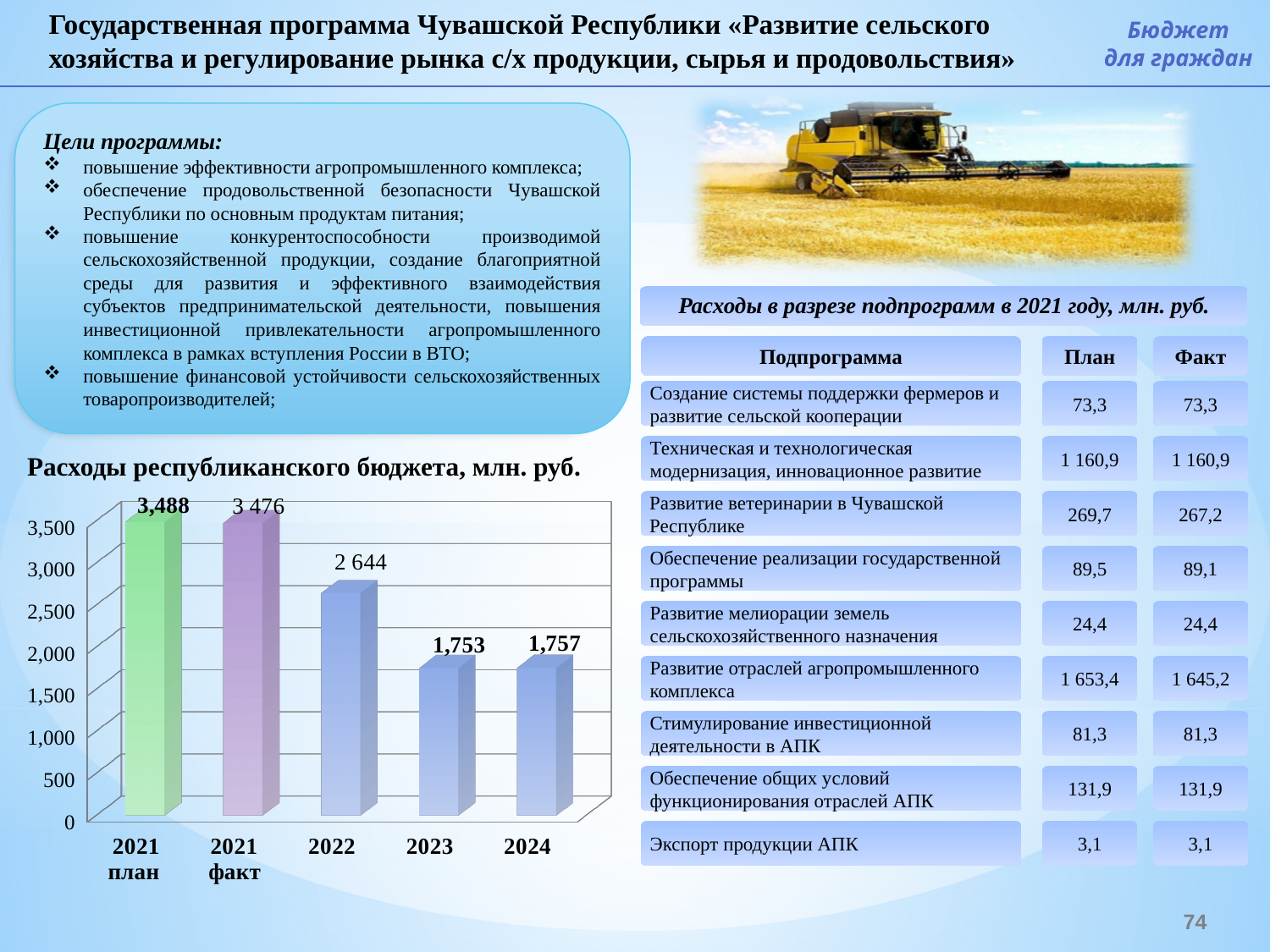
In the chart 'Расходы республиканского бюджета, млн. руб.', which category has the lowest value? 2023 In the chart 'Расходы республиканского бюджета, млн. руб.', what is the difference between the 2021 план and 2021 факт values? 12 What kind of chart is 'Расходы республиканского бюджета, млн. руб.'? Bar chart In the chart 'Расходы республиканского бюджета, млн. руб.', which category has the highest value? 2021 план In the chart 'Расходы республиканского бюджета, млн. руб.', which is larger, the value for 2022 or the value for 2024? 2022 In the chart 'Расходы республиканского бюджета, млн. руб.', what is the value for 2023? 1,753 How many bars are shown in the chart 'Расходы республиканского бюджета, млн. руб.'? 5 In the chart 'Расходы республиканского бюджета, млн. руб.', what is the difference between the 2022 and 2023 values? 891 In the chart 'Расходы республиканского бюджета, млн. руб.', what is the value for 2021 план? 3,488 In the chart 'Расходы республиканского бюджета, млн. руб.', what is the value for 2022? 2 644 In the chart 'Расходы республиканского бюджета, млн. руб.', what is the value for 2024? 1,757 In the chart 'Расходы республиканского бюджета, млн. руб.', what is the value for 2021 факт? 3 476